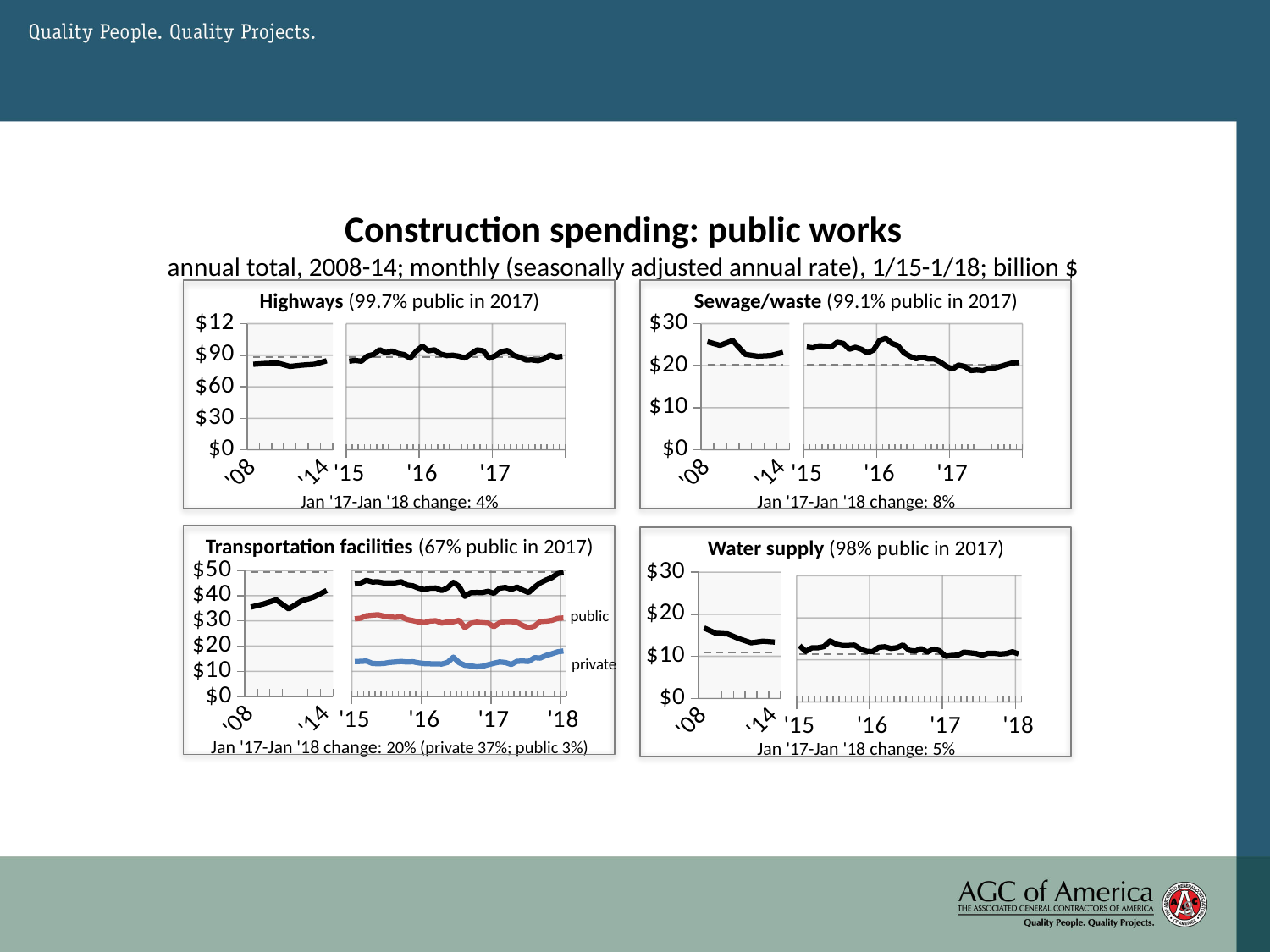
What kind of chart is the Highways chart? line chart In the Water supply chart, do values rise or fall from '08 to '14? fall In the Transportation facilities chart, how many series are labelled on the right side of the plot? 2 What is the Jan '17-Jan '18 change shown for the Water supply chart? 5% What is the Jan '17-Jan '18 change shown for the Sewage/waste chart? 8% In the Water supply chart, is the value for 2008 greater or less than $20? less In the Transportation facilities chart, which series is higher in 2017, public or private? public In the Sewage/waste chart, is the value for 2008 greater or less than $20? greater Which of the four categories has the lowest percentage public in 2017 according to the chart titles? Transportation facilities What is the Jan '17-Jan '18 change shown for the Highways chart? 4% What is the Jan '17-Jan '18 change shown for the Transportation facilities chart? 20% How many charts are shown on the slide? 4